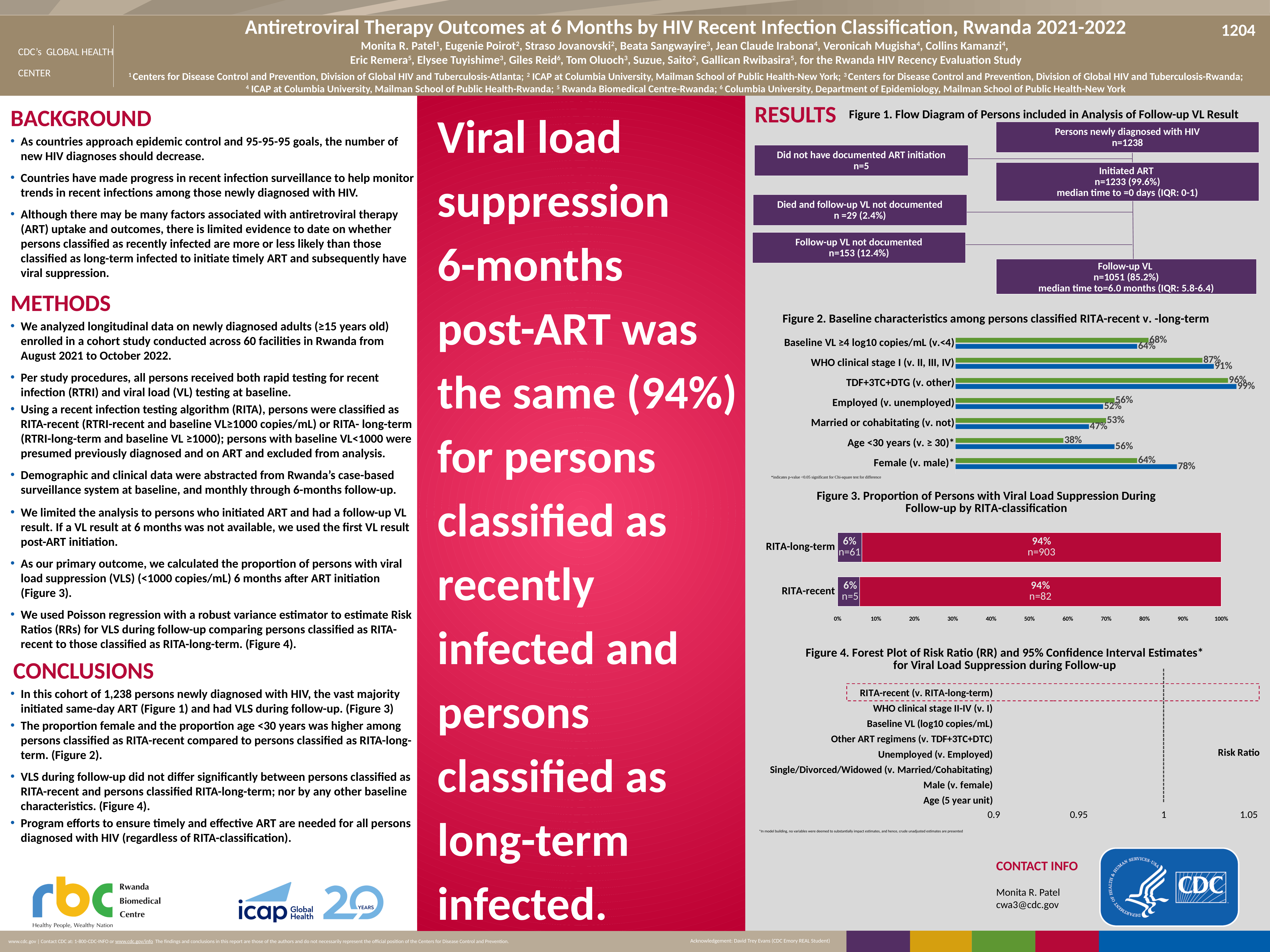
What kind of chart is Figure 2? bar chart In Figure 3, what is the n shown in the red segment for RITA-long-term? n=903 In Figure 2, what value is labelled on the blue bar for 'Female (v. male)'? 78% In Figure 2, for 'Married or cohabitating (v. not)', which bar is larger, the green bar or the blue bar? green bar In Figure 3, what percentage of RITA-recent persons had viral load suppression (the red segment)? 94% In Figure 2, what is the difference between the blue bar (78%) and the green bar (64%) for 'Female (v. male)'? 14% In Figure 2, which category has the highest labelled value? TDF+3TC+DTG (v. other) In Figure 2, what value is labelled on the blue bar for 'TDF+3TC+DTG (v. other)'? 99% In Figure 2, what value is labelled on the green bar for 'Age <30 years (v. ≥ 30)'? 38% In Figure 2, which category has the lowest labelled value? Age <30 years (v. ≥ 30) How many categories are listed on the y axis of Figure 2? 7 In Figure 3, what is the total of the two segments for the RITA-long-term bar (6% + 94%)? 100%